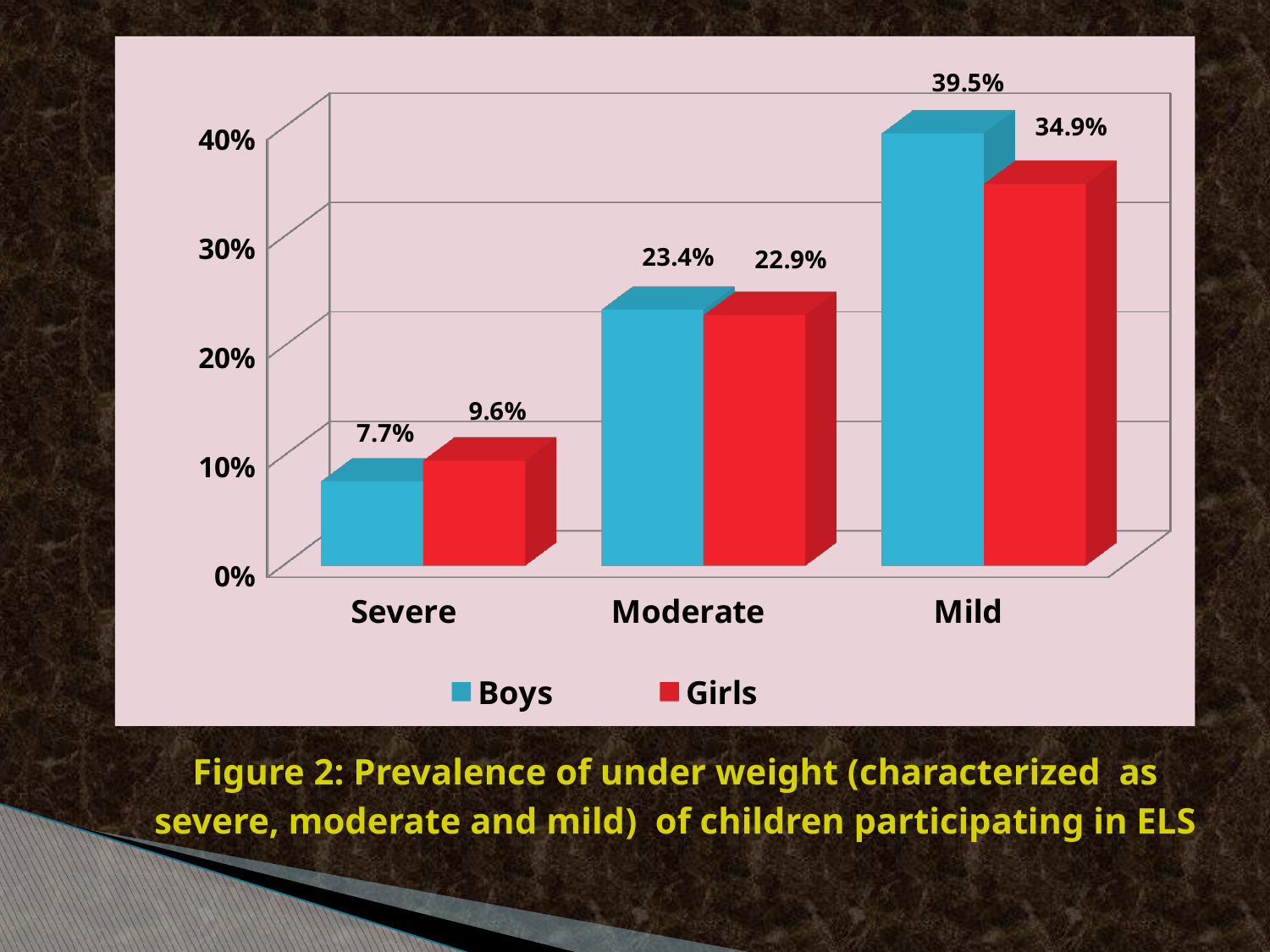
What is the value for Girls in the Moderate category? 22.9% Which colour represents Girls in the chart? Red How many series does the legend list? 2 In the Severe category, which is larger, the Boys value or the Girls value? Girls Which category has the lowest value for Girls? Severe What is the value for Boys in the Severe category? 7.7% What is the value for Girls in the Mild category? 34.9% Which category has the highest value for Boys? Mild Is the value for Boys in the Mild category greater or less than 30%? greater What is the difference between the Boys and Girls values in the Mild category? 4.6% What kind of chart is shown on the slide? Bar chart How many categories are shown on the x axis? 3